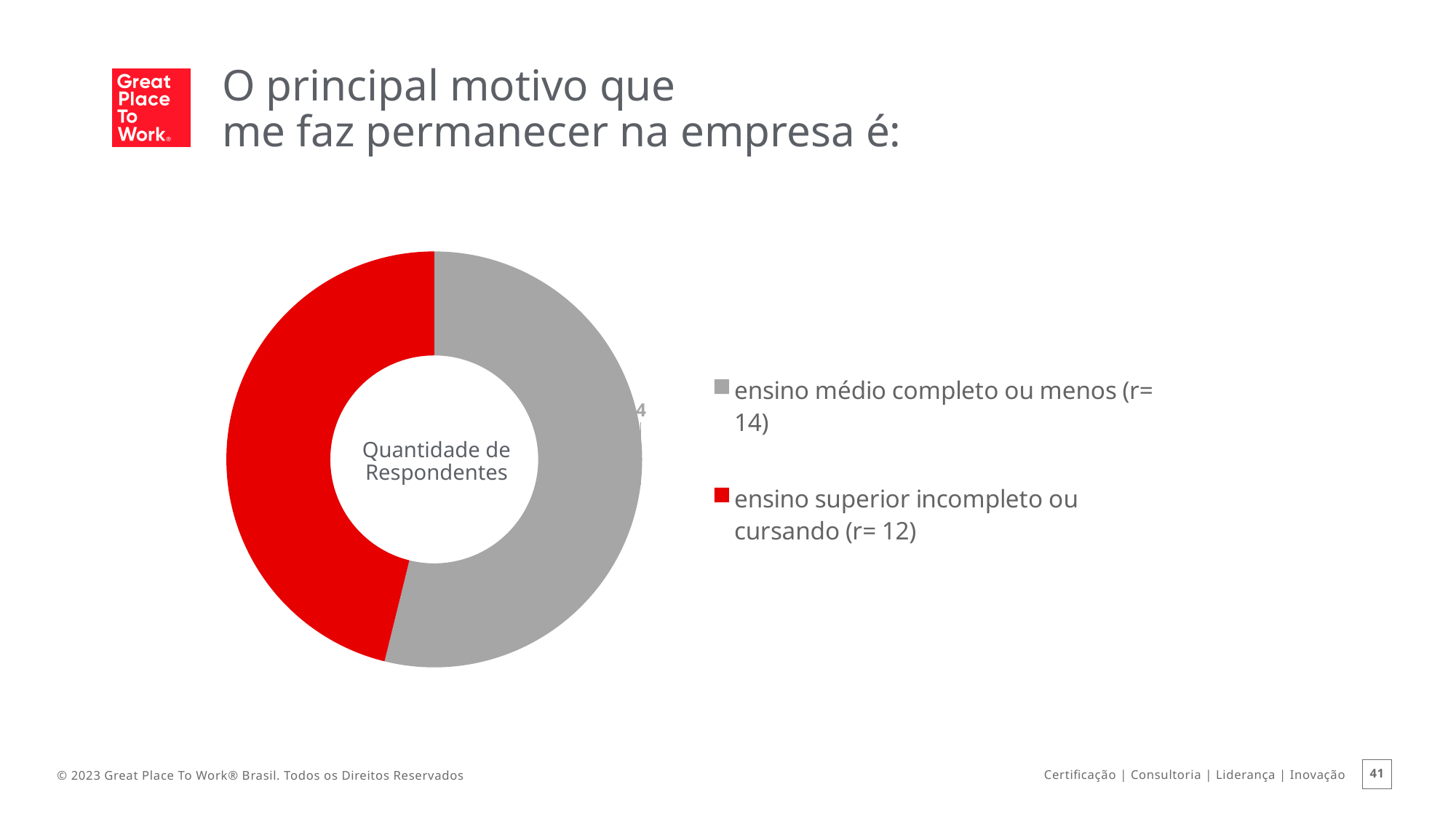
Which has more respondents: 'ensino médio completo ou menos' or 'ensino superior incompleto ou cursando'? ensino médio completo ou menos What is the difference in respondents between 'ensino médio completo ou menos' (r= 14) and 'ensino superior incompleto ou cursando' (r= 12)? 2 What text is shown in the centre of the doughnut chart? Quantidade de Respondentes What kind of chart is shown on the slide? Doughnut (pie) chart What is the number of respondents (r) for 'ensino superior incompleto ou cursando' according to the legend? 12 Which category has the larger slice of the doughnut chart? ensino médio completo ou menos What colour is the slice for 'ensino superior incompleto ou cursando'? Red How many entries does the legend list? 2 Which category has the smaller slice of the doughnut chart? ensino superior incompleto ou cursando What is the number of respondents (r) for 'ensino médio completo ou menos' according to the legend? 14 How many categories does the doughnut chart show? 2